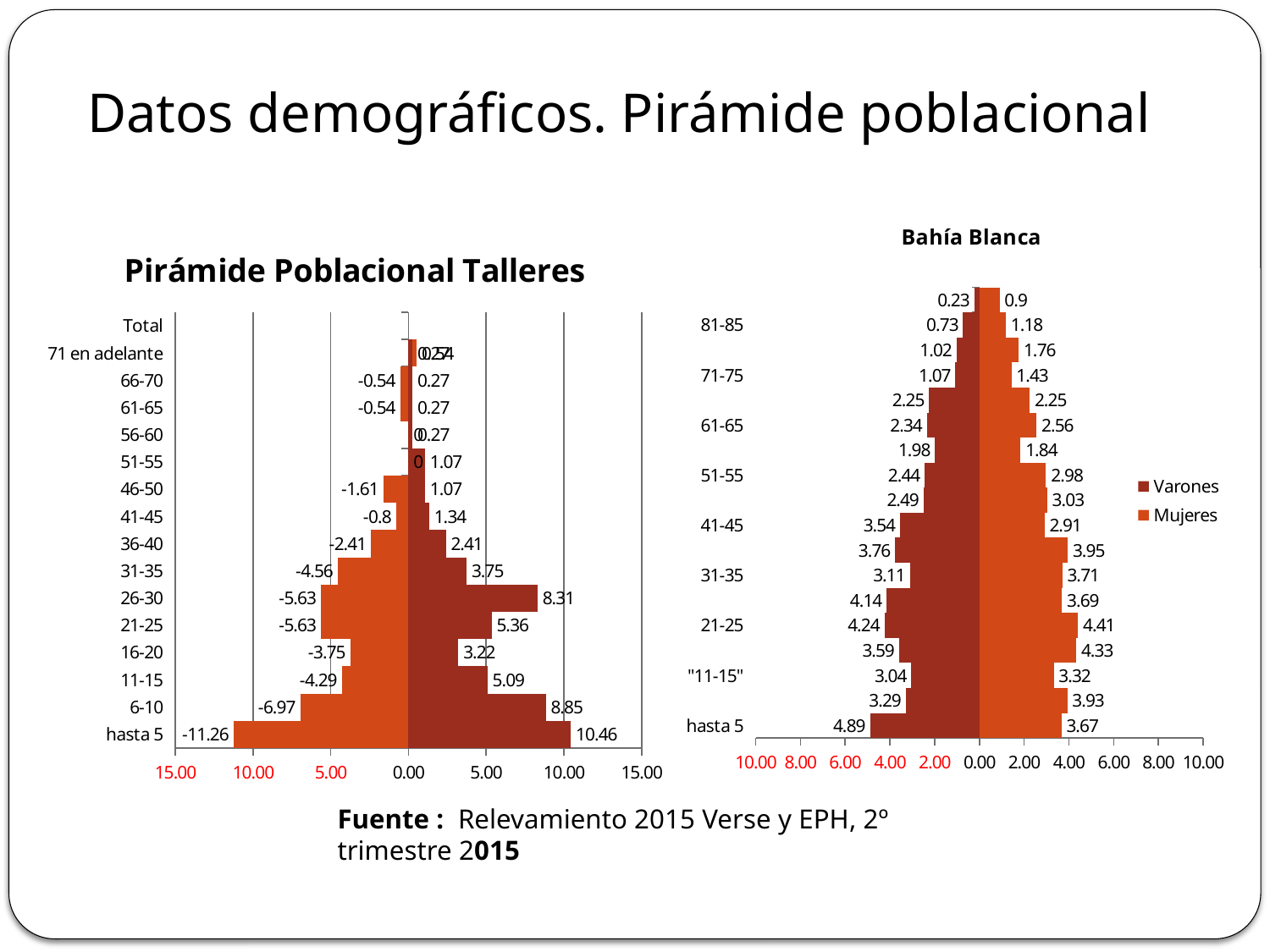
What kind of chart is the Bahía Blanca chart? Bar chart In the Bahía Blanca chart, what is the Varones value for the 'hasta 5' age group? 4.89 In the Pirámide Poblacional Talleres chart, what is the value of the left-hand (negative) bar for the 6-10 age group? -6.97 In the Pirámide Poblacional Talleres chart, what is the value of the right-hand (positive) bar for the 26-30 age group? 8.31 How many series does the legend of the Bahía Blanca chart list? 2 In the Bahía Blanca chart, which is larger for the 41-45 age group, Varones or Mujeres? Varones In the Pirámide Poblacional Talleres chart, what is the value of the right-hand (positive) bar for 'hasta 5'? 10.46 In the Pirámide Poblacional Talleres chart, which age group has the largest right-hand (positive) bar? hasta 5 In the Bahía Blanca chart, what is the difference between the Mujeres and Varones values for the 21-25 age group? 0.17 In the Bahía Blanca chart, what is the Varones value for the 81-85 age group? 0.73 In the Bahía Blanca chart, what is the Mujeres value for the 21-25 age group? 4.41 What are the two legend entries in the Bahía Blanca chart? Varones and Mujeres